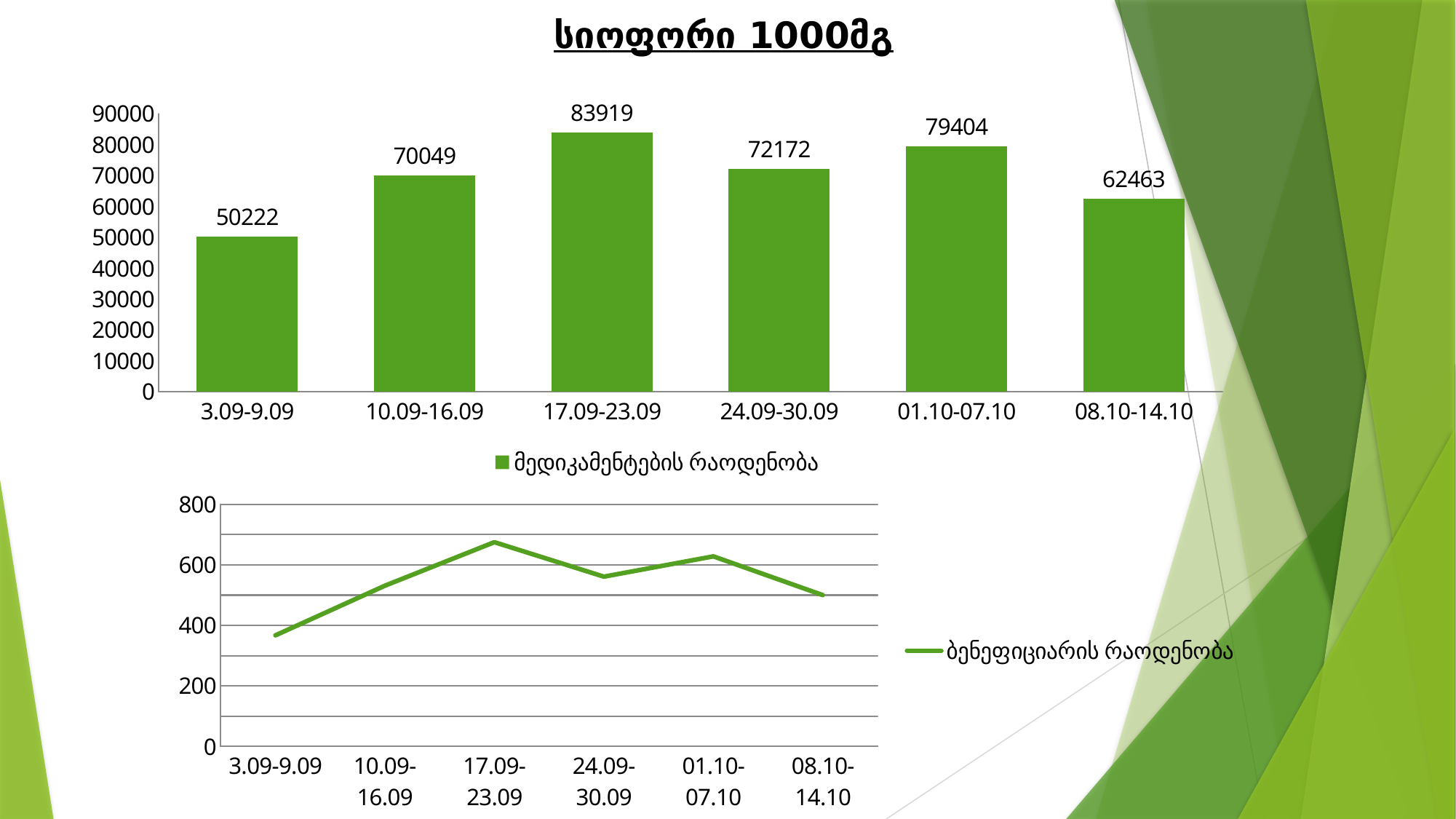
On the top bar chart, what is the value for 3.09-9.09? 50222 On the bottom line chart, is the value for 3.09-9.09 greater or less than 400? less What kind of chart is the top chart on the slide? bar chart On the top bar chart, which is larger: the value for 10.09-16.09 or the value for 24.09-30.09? 24.09-30.09 On the top bar chart, which period has the lowest value? 3.09-9.09 On the top bar chart, what is the difference between the values for 01.10-07.10 and 08.10-14.10? 16941 On the top bar chart, what is the value for 17.09-23.09? 83919 How many periods are shown on the top bar chart? 6 On the bottom line chart, is the value for 17.09-23.09 greater or less than 600? greater What kind of chart is the bottom chart on the slide? line chart What is the title of the top bar chart? სიოფორი 1000მგ On the top bar chart, which period has the highest value? 17.09-23.09